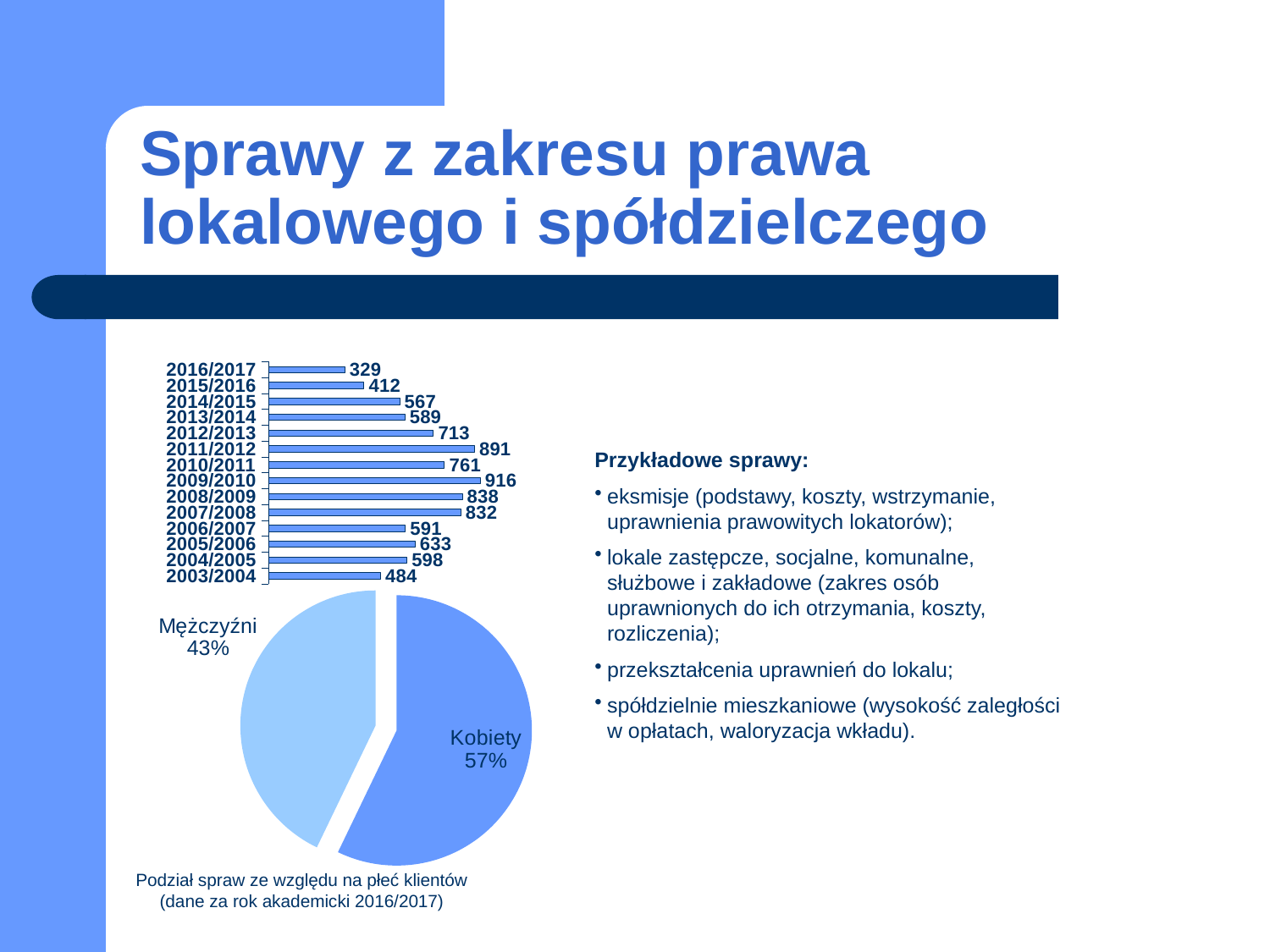
In the pie chart, what share of cases is for Kobiety? 57% In the bar chart, which is larger: the value for 2008/2009 or the value for 2007/2008? 2008/2009 In the bar chart, what is the value for 2016/2017? 329 In the bar chart, what is the difference between the values for 2011/2012 and 2010/2011? 130 In the pie chart, what share of cases is for Mężczyźni? 43% In the bar chart, which academic year has the lowest value? 2016/2017 How many academic years are shown in the bar chart? 14 What is the caption below the pie chart? Podział spraw ze względu na płeć klientów (dane za rok akademicki 2016/2017) In the bar chart, what is the value for 2009/2010? 916 In the bar chart, what is the value for 2003/2004? 484 In the bar chart, which academic year has the highest value? 2009/2010 What kind of chart is the upper chart on the slide? bar chart